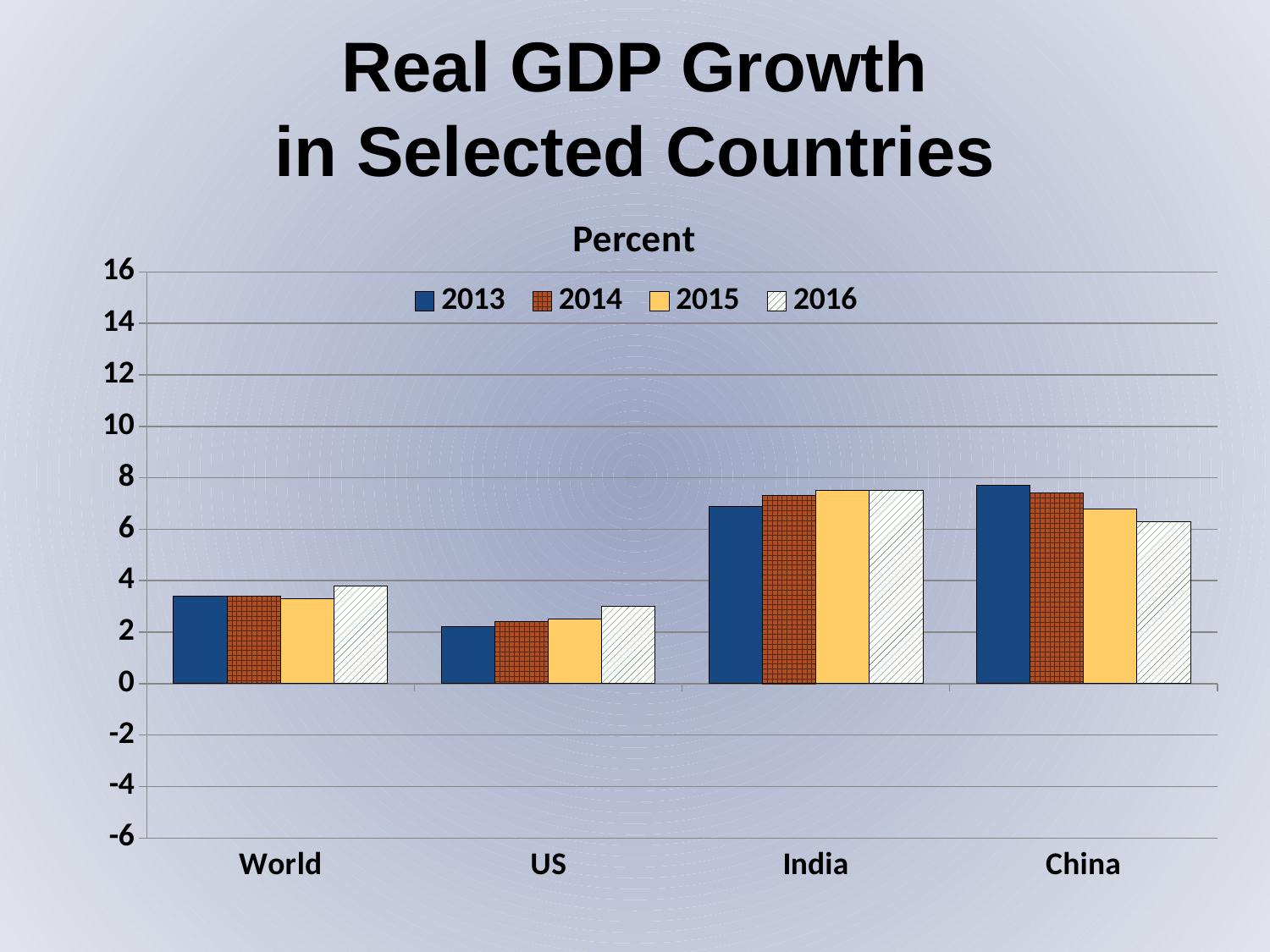
Which is larger, the 2016 value for India or the 2016 value for China? India How many series does the legend list? 4 Which years are listed in the legend? 2013, 2014, 2015, 2016 What is the label shown above the chart's y axis? Percent How many countries or regions are shown on the x axis? 4 Is the value for US in 2013 greater or less than 4? less Which country or region has the highest bar for 2016? India What kind of chart is shown on the slide? bar chart Do the bars for China rise or fall from 2013 to 2016? fall Is the value for China in 2013 greater or less than 6? greater Which country or region has the lowest bar for 2013? US Which country or region has the highest bar for 2013? China